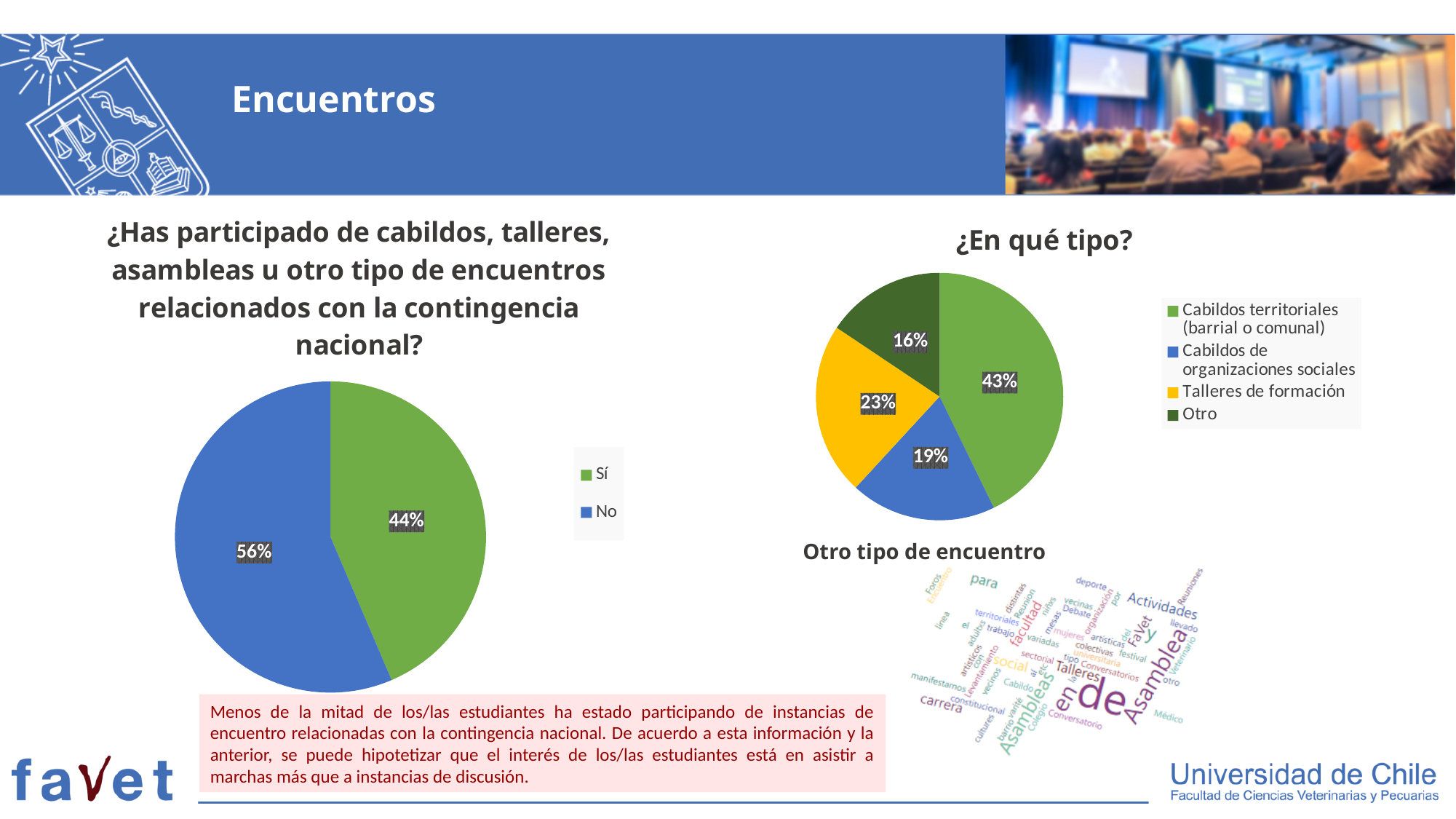
In the right pie chart (¿En qué tipo?), which category has the largest share? Cabildos territoriales (barrial o comunal) In the left pie chart, what percentage answered No? 56% In the right pie chart (¿En qué tipo?), how many categories are shown? 4 How many entries does the legend of the left pie chart list? 2 In the right pie chart (¿En qué tipo?), what is the difference in percentage points between Cabildos de organizaciones sociales and Otro? 3 In the left pie chart, what is the difference in percentage points between No and Sí? 12 In the left pie chart (¿Has participado de cabildos, talleres, asambleas u otro tipo de encuentros relacionados con la contingencia nacional?), what percentage answered Sí? 44% In the left pie chart, which response has the larger share, Sí or No? No In the right pie chart (¿En qué tipo?), what percentage corresponds to Cabildos territoriales (barrial o comunal)? 43% In the right pie chart (¿En qué tipo?), what percentage corresponds to Talleres de formación? 23% What kind of chart is the left chart on the slide? Pie chart In the right pie chart (¿En qué tipo?), which category has the smallest share? Otro